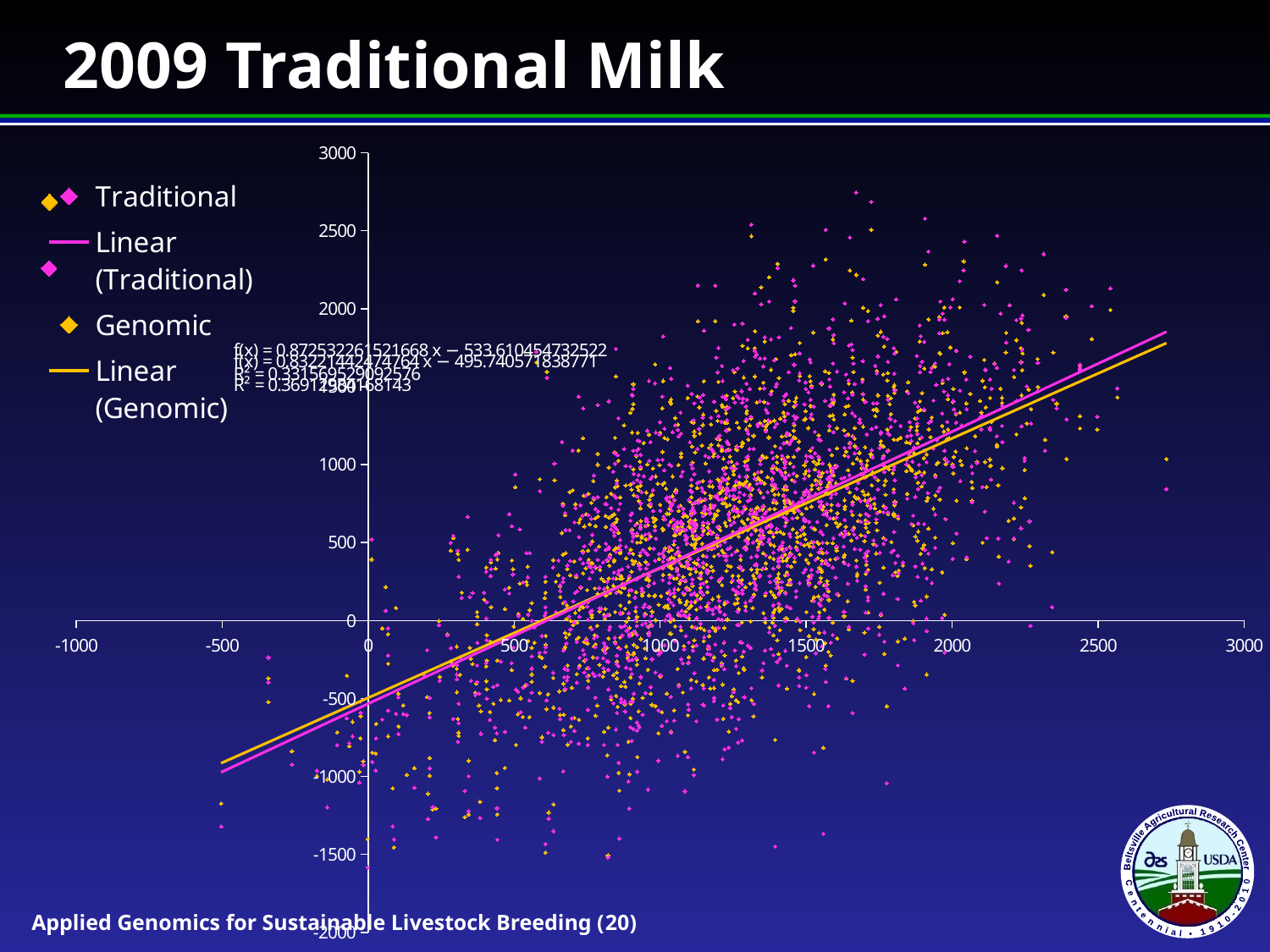
Does the Linear (Traditional) trendline slope upward or downward across the chart? Upward What is the highest value labelled on the x axis of the chart? 3000 What kind of chart is shown on the slide? Scatter chart How many entries does the chart's legend list? 4 Which two data series are plotted as points in the chart? Traditional and Genomic What is the lowest value labelled on the x axis of the chart? -1000 Do the plotted values generally rise or fall as the x-axis values increase? Rise What is the lowest value labelled on the y axis of the chart? -2000 What is the highest value labelled on the y axis of the chart? 3000 What is the title of the chart on the slide? 2009 Traditional Milk